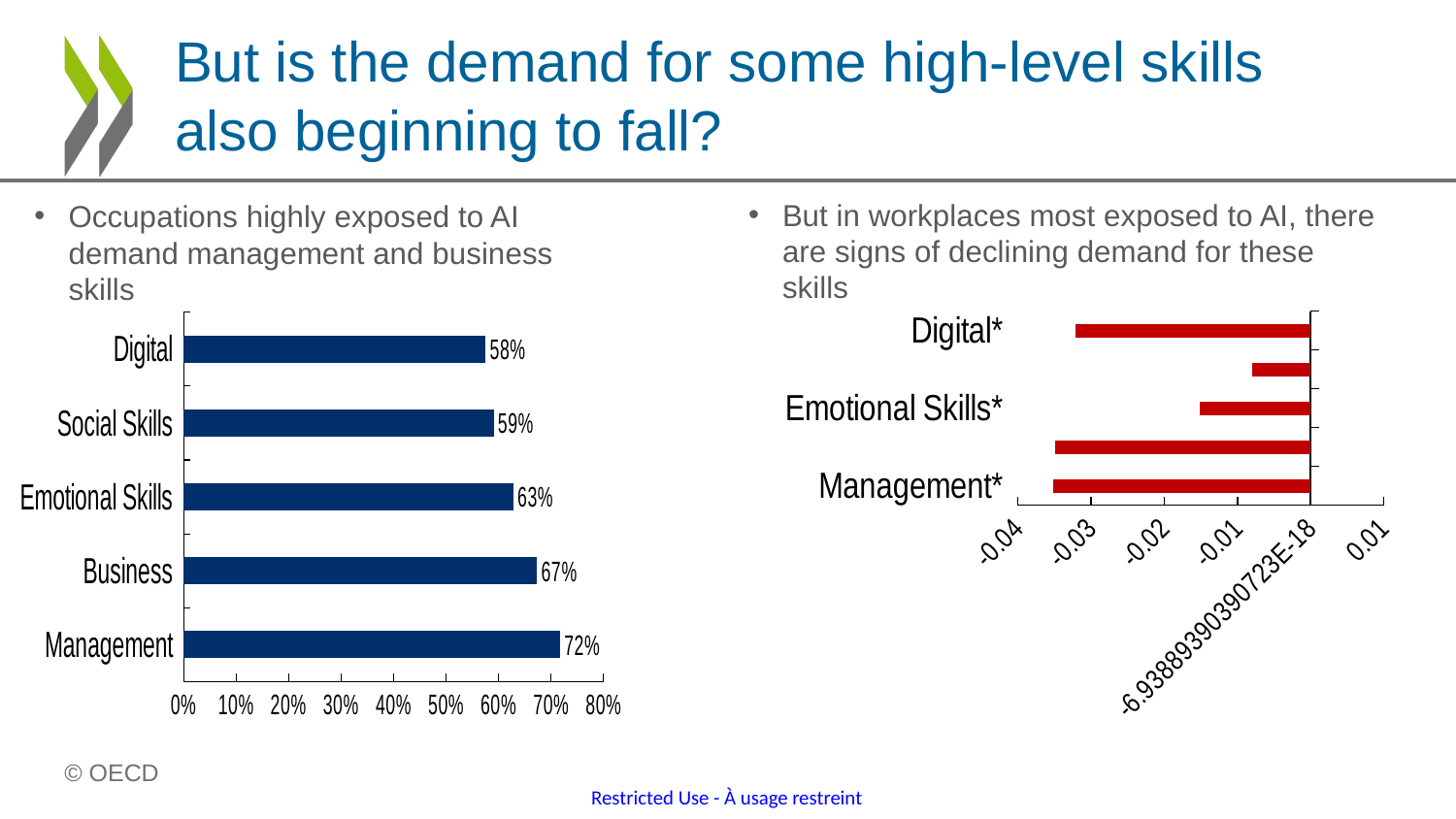
In the left chart, which category has the lowest value? Digital How many categories are shown in the left chart? 5 What kind of chart is the left chart? Bar chart In the left chart, what is the value for Emotional Skills? 63% In the left chart, what is the value for Management? 72% In the left chart, which category has the highest value? Management In the left chart, which is larger, the value for Business or the value for Social Skills? Business In the left chart, what is the difference between the values for Emotional Skills and Social Skills? 4% In the left chart, what is the difference between the values for Management and Business? 5% In the right chart, is the value for Emotional Skills* greater or less than -0.02? greater In the left chart, what is the value for Digital? 58% What colour are the bars in the right chart? Red